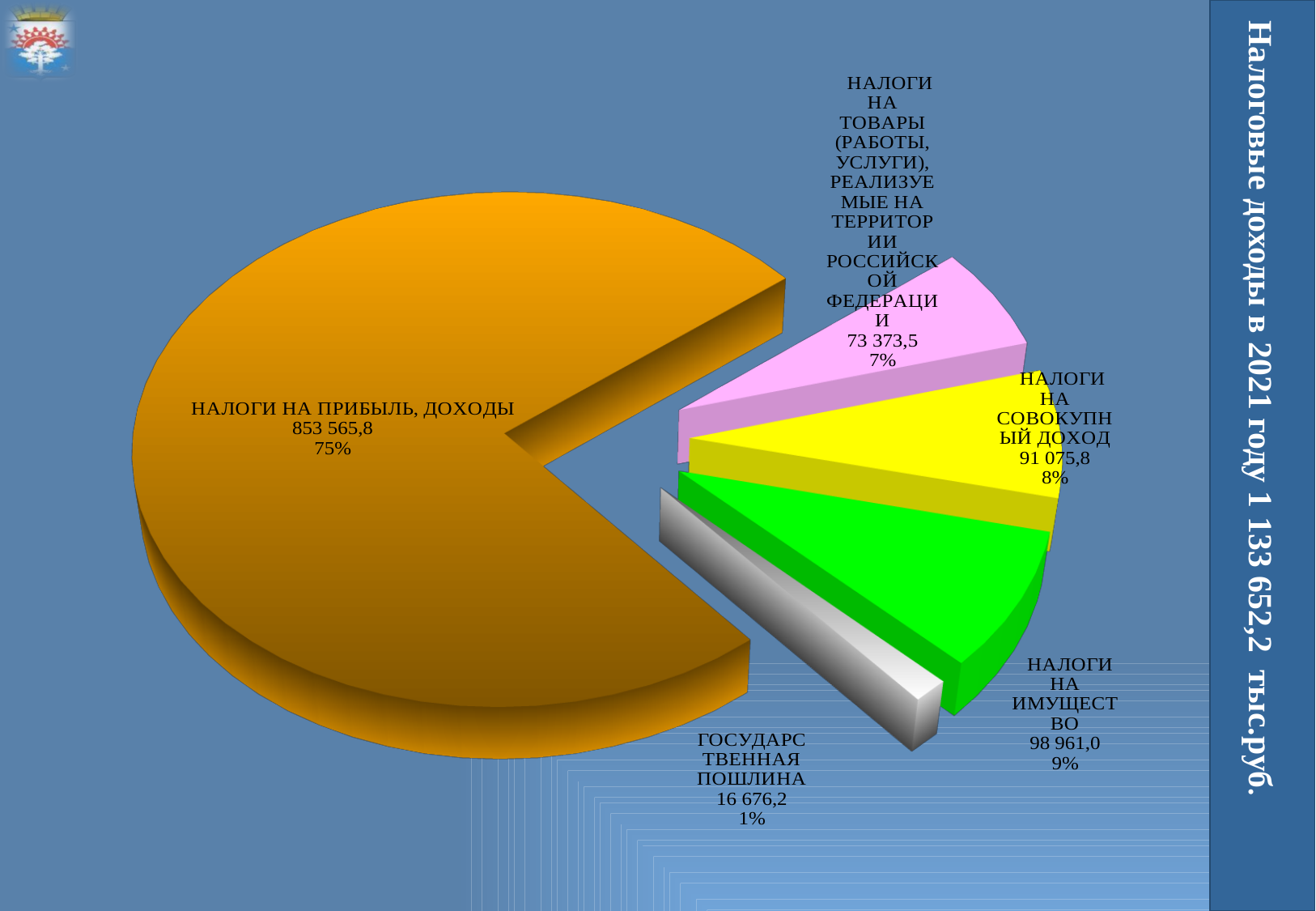
What is the value shown for ГОСУДАРСТВЕННАЯ ПОШЛИНА? 16 676,2 Which category has the largest slice of the pie? НАЛОГИ НА ПРИБЫЛЬ, ДОХОДЫ What is the difference between the values for НАЛОГИ НА ИМУЩЕСТВО and НАЛОГИ НА СОВОКУПНЫЙ ДОХОД? 7 885,2 What kind of chart is shown on the slide? pie chart What is the value shown for НАЛОГИ НА ИМУЩЕСТВО? 98 961,0 What is the value shown for НАЛОГИ НА ПРИБЫЛЬ, ДОХОДЫ? 853 565,8 What share of the pie does НАЛОГИ НА ПРИБЫЛЬ, ДОХОДЫ represent? 75% What share of the pie does НАЛОГИ НА ТОВАРЫ (РАБОТЫ, УСЛУГИ), РЕАЛИЗУЕМЫЕ НА ТЕРРИТОРИИ РОССИЙСКОЙ ФЕДЕРАЦИИ represent? 7% Which category has the smallest slice of the pie? ГОСУДАРСТВЕННАЯ ПОШЛИНА How many slices does the pie chart have? 5 Which is larger: НАЛОГИ НА ИМУЩЕСТВО or НАЛОГИ НА СОВОКУПНЫЙ ДОХОД? НАЛОГИ НА ИМУЩЕСТВО What is the value shown for НАЛОГИ НА СОВОКУПНЫЙ ДОХОД? 91 075,8